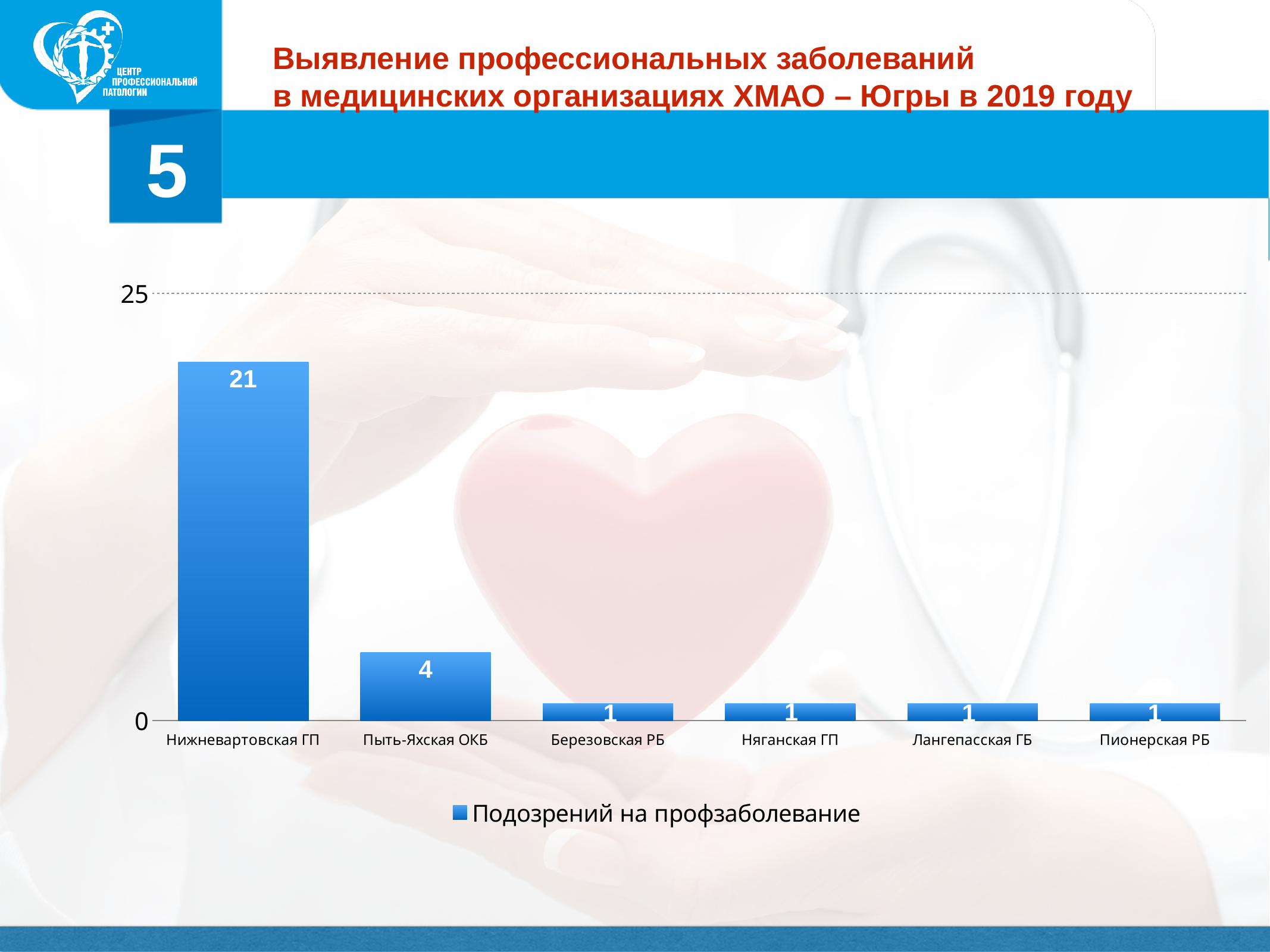
What kind of chart is shown on the slide? bar chart What is the legend entry for the series? Подозрений на профзаболевание How many series does the legend list? 1 What is the difference between the values for Нижневартовская ГП and Пыть-Яхская ОКБ? 17 What is the value for Няганская ГП? 1 Is the value for Нижневартовская ГП greater or less than 25? less What is the value for Пыть-Яхская ОКБ? 4 Which is larger, the value for Пыть-Яхская ОКБ or the value for Березовская РБ? Пыть-Яхская ОКБ How many categories are shown on the x axis? 6 How many categories have a value of 1? 4 What is the value for Нижневартовская ГП? 21 Which category has the highest value? Нижневартовская ГП